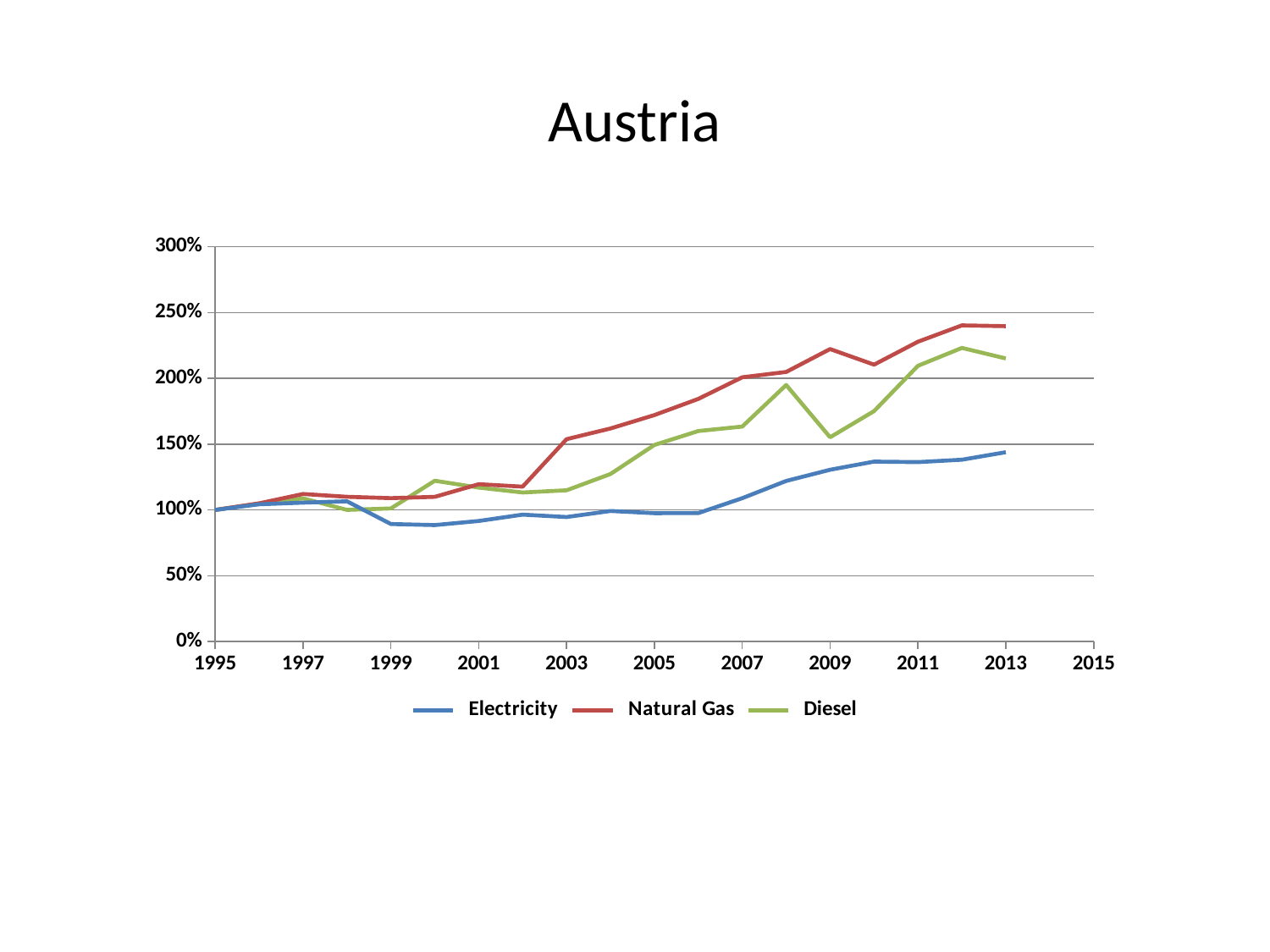
Which series has the lowest value in 2013? Electricity Which colour is used for the Electricity series? blue Is the value for Diesel in 2012 greater or less than 200%? greater Is the value for Electricity in 1999 greater or less than 100%? less What is the title of the chart? Austria Is the value for Natural Gas in 2013 greater or less than 200%? greater How many series does the legend list? 3 Which series has the highest value in 2013? Natural Gas What is the value for Natural Gas in 1995? 100% In 2009, which is larger: the value for Natural Gas or the value for Diesel? Natural Gas What kind of chart is shown on the slide? line chart